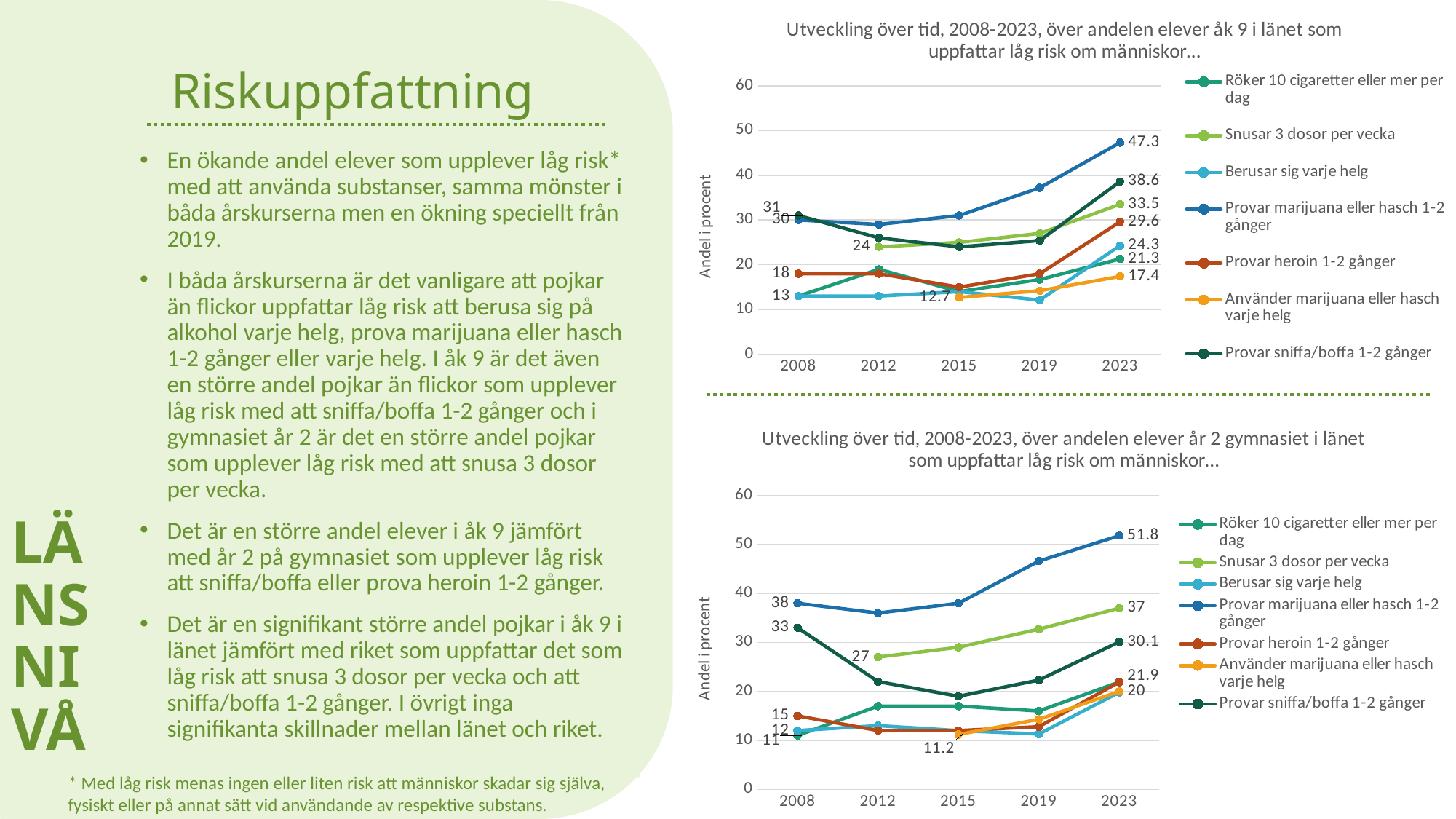
How many series does the legend of the top chart (åk 9) list? 7 In the bottom chart (år 2 gymnasiet), what is the value for 'Snusar 3 dosor per vecka' in 2023? 37 In the top chart (åk 9), what is the value for 'Provar marijuana eller hasch 1-2 gånger' in 2023? 47.3 In the top chart (åk 9), what is the difference between the 2023 values for 'Provar marijuana eller hasch 1-2 gånger' (47.3) and 'Provar sniffa/boffa 1-2 gånger' (38.6)? 8.7 In the bottom chart (år 2 gymnasiet), is the value for 'Provar marijuana eller hasch 1-2 gånger' larger in 2008 or in 2023? 2023 How many years are shown on the x axis of the top chart (åk 9)? 5 In the bottom chart (år 2 gymnasiet), does the value for 'Provar marijuana eller hasch 1-2 gånger' rise or fall from 2012 to 2023? Rise In the top chart (åk 9), which series has the highest value in 2023? Provar marijuana eller hasch 1-2 gånger In the bottom chart (år 2 gymnasiet), what is the value for 'Provar marijuana eller hasch 1-2 gånger' in 2023? 51.8 In the top chart (åk 9), which series has the lowest value in 2023? Använder marijuana eller hasch varje helg What kind of chart is the top chart (åk 9)? Line chart In the bottom chart (år 2 gymnasiet), is the value for 'Snusar 3 dosor per vecka' in 2019 greater or less than 30? greater